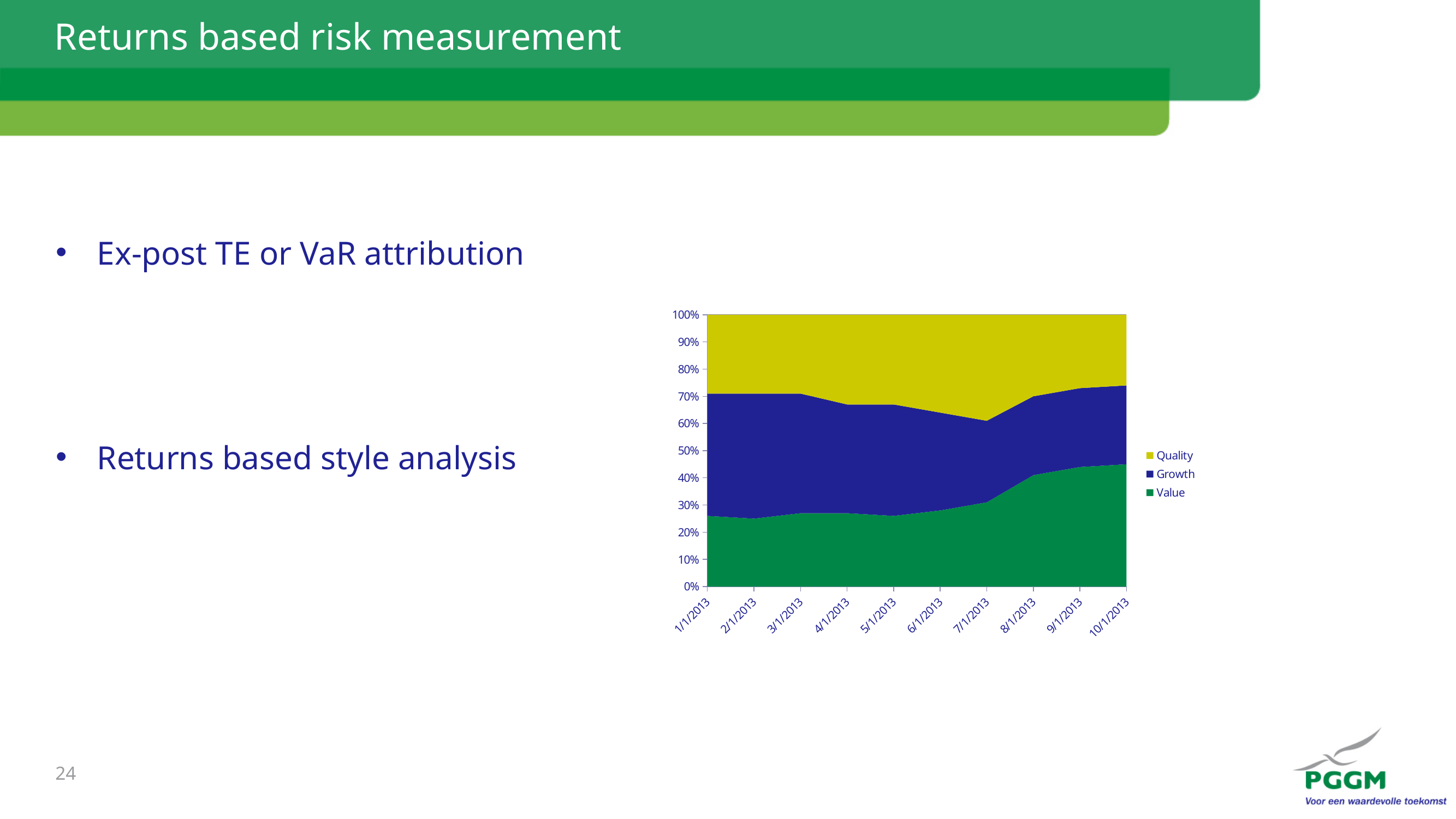
Does the Value series rise or fall from 1/1/2013 to 10/1/2013? rise How many dates are shown along the x axis of the chart? 10 Which series is plotted at the bottom of the stacked area chart? Value Is the value for Value at 1/1/2013 greater or less than 30%? less How many series does the chart's legend list? 3 Is the value for Value at 5/1/2013 greater or less than 30%? less Is the share of Quality at 1/1/2013 greater or less than 40%? less What kind of chart is shown on the slide? stacked area chart Which is larger at 10/1/2013, the share of Value or the share of Quality? Value Which series are listed in the chart's legend? Quality, Growth, Value